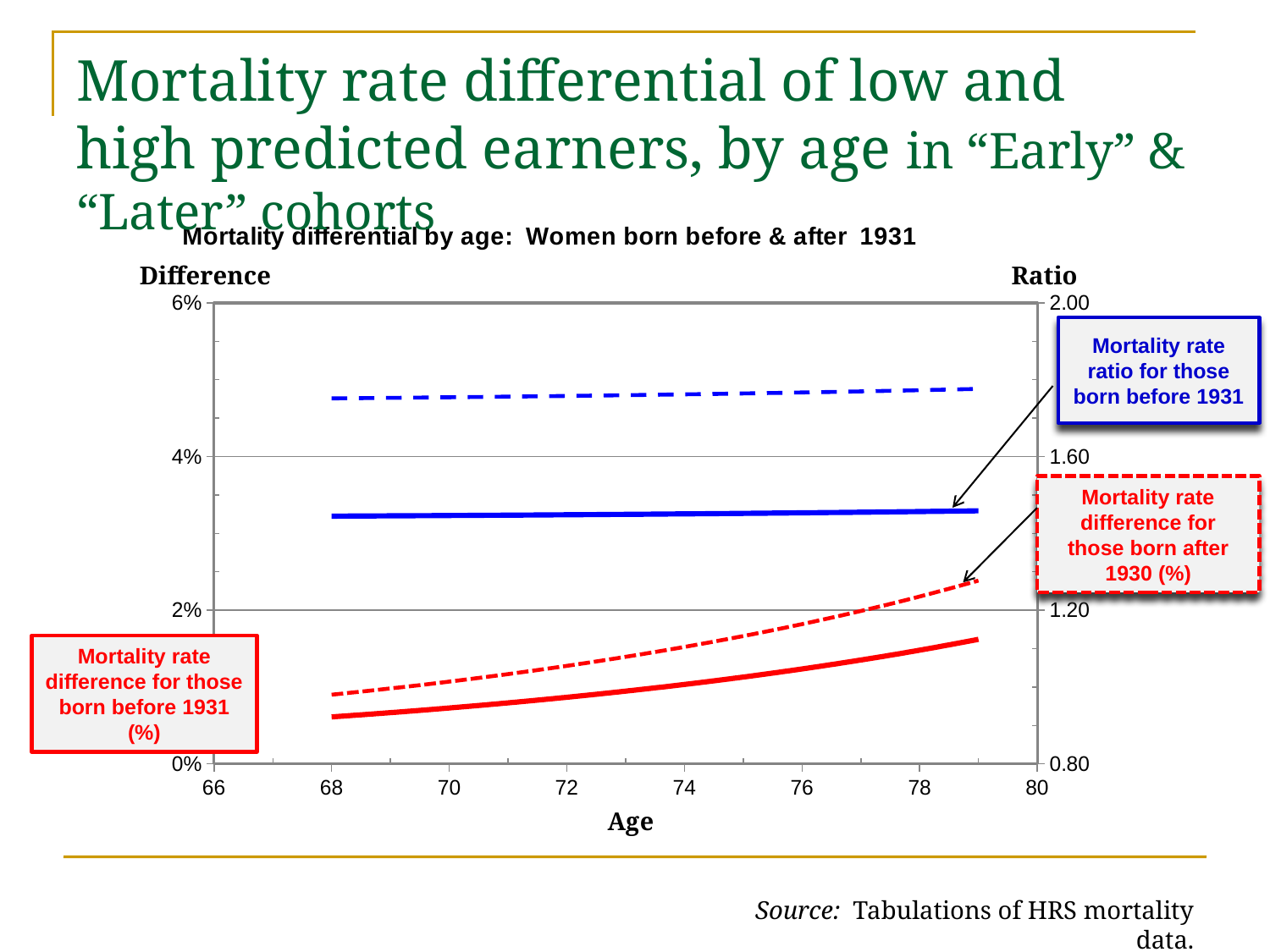
What kind of chart is shown on the slide? line chart What is the label of the horizontal axis? Age Is the mortality rate ratio for those born before 1931 (solid blue line) at age 78 greater or less than 1.60? less How many lines are plotted on the chart? 4 At age 74, which is higher: the dashed blue line or the solid blue line? the dashed blue line What is the title printed above the chart? Mortality differential by age: Women born before & after 1931 Is the mortality rate difference for those born after 1930 (dashed red line) at age 79 greater or less than 2%? greater Does the mortality rate difference for those born before 1931 (solid red line) rise or fall as age increases? rise What is the highest value shown on the right-hand (Ratio) axis? 2.00 Does the mortality rate difference for those born after 1930 (dashed red line) rise or fall as age increases? rise Is the mortality rate difference for those born before 1931 (solid red line) at age 68 greater or less than 2%? less At age 78, which is higher: the dashed red line or the solid red line? the dashed red line